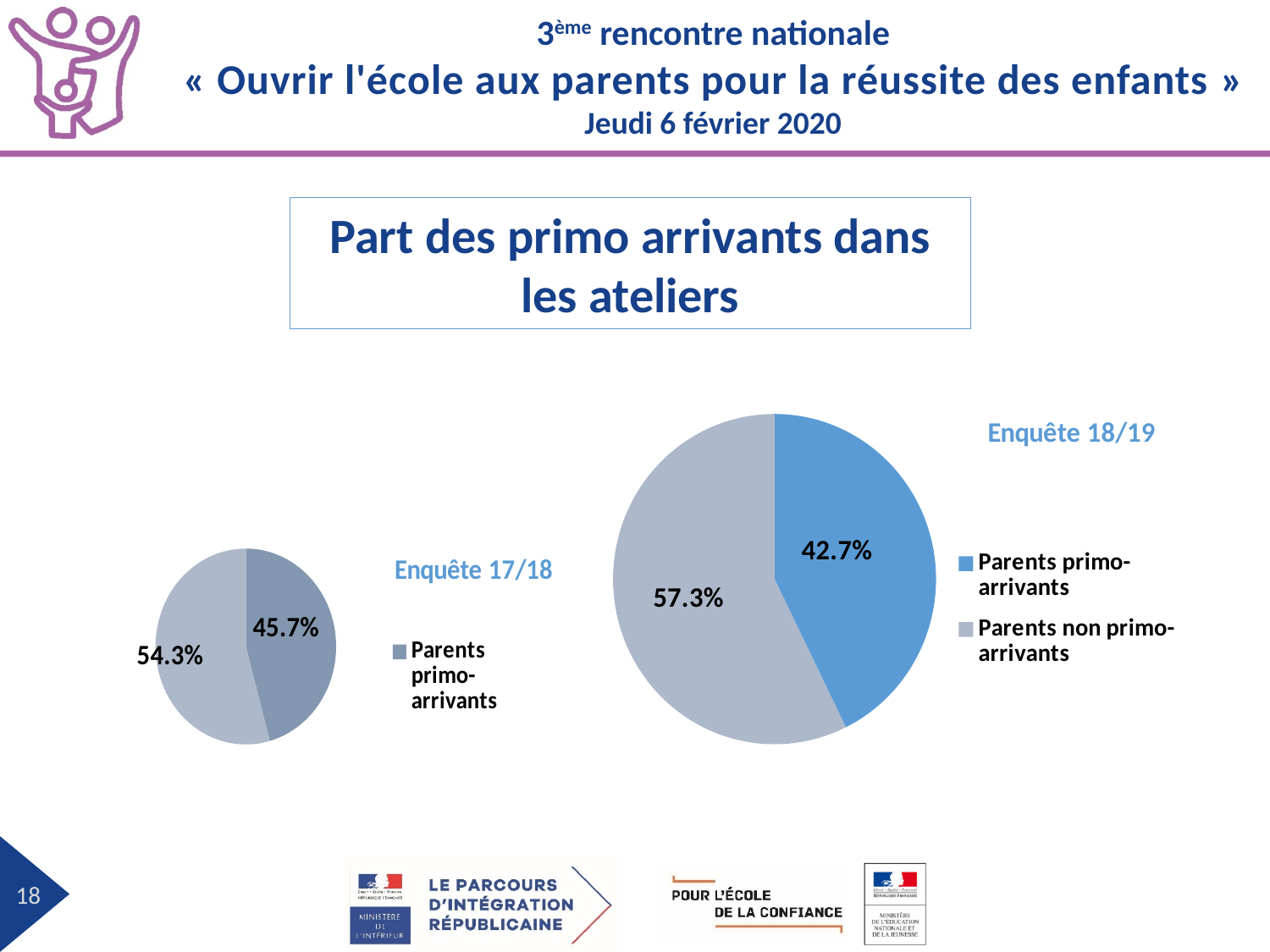
What is the title shown above the two pie charts? Part des primo arrivants dans les ateliers In the 'Enquête 18/19' chart, what share is shown for Parents non primo-arrivants? 57.3% How many entries does the legend of the 'Enquête 18/19' chart list? 2 In the 'Enquête 17/18' chart, what is the value of the larger slice? 54.3% In the 'Enquête 18/19' chart, what is the difference between the two slices? 14.6% Which is larger: the share of Parents primo-arrivants in 'Enquête 17/18' or in 'Enquête 18/19'? Enquête 17/18 In the 'Enquête 18/19' chart, what share is shown for Parents primo-arrivants? 42.7% What kind of chart is used for 'Enquête 18/19'? Pie chart How many slices does the 'Enquête 18/19' pie chart have? 2 In the 'Enquête 18/19' chart, which category has the smallest slice? Parents primo-arrivants In the 'Enquête 17/18' chart, what share is shown for Parents primo-arrivants? 45.7% In the 'Enquête 17/18' chart, what is the difference between the two slices? 8.6%